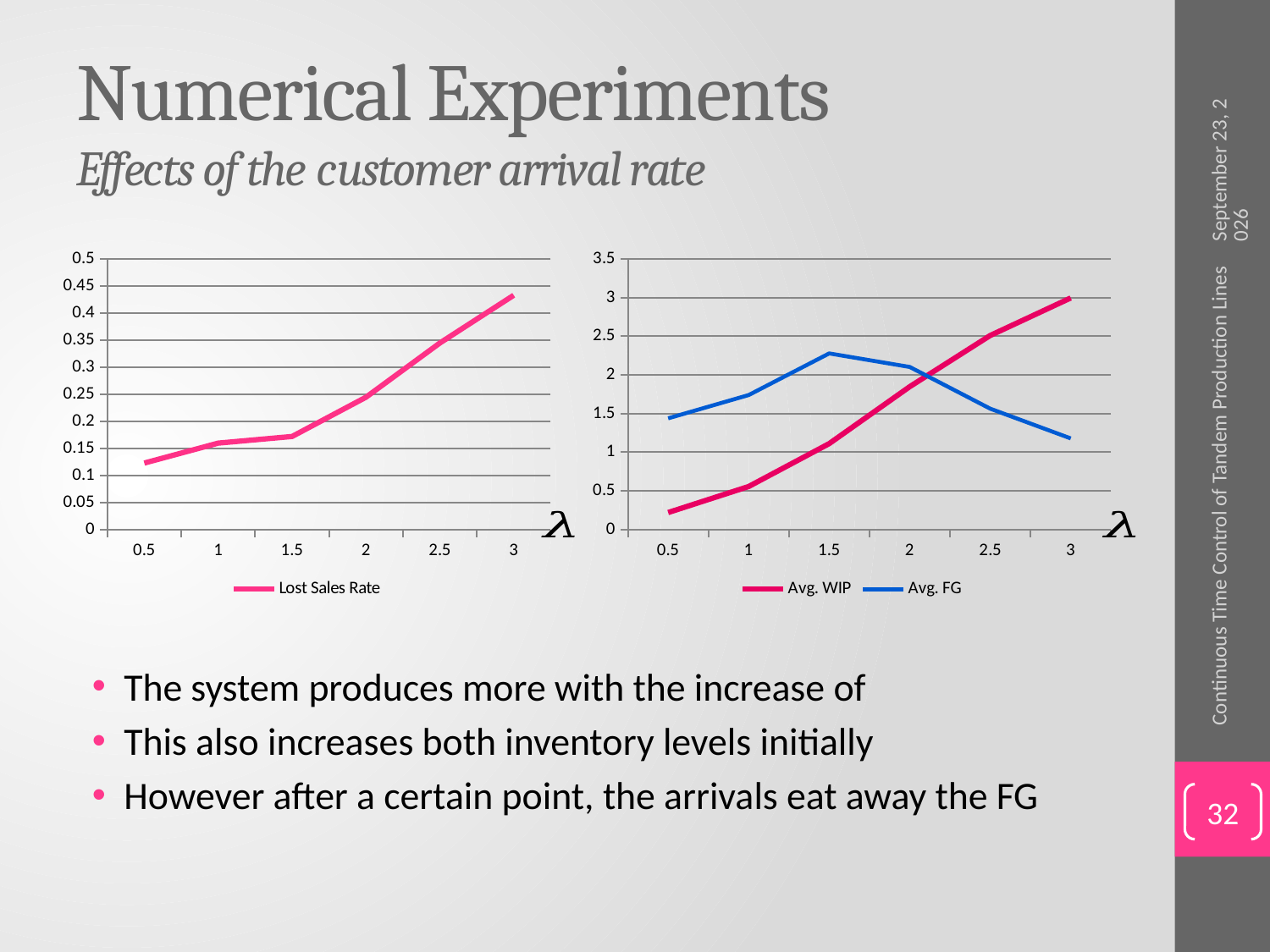
How many x-axis points are plotted in the left chart? 6 In the right chart, is Avg. WIP at λ = 2.5 greater or less than 2? greater In the left chart, is the Lost Sales Rate at λ = 0.5 greater or less than 0.15? less What series does the legend of the left chart list? Lost Sales Rate How many series does the legend of the right chart list? 2 What type of chart is the left chart on the slide? line chart In the right chart, at which value of λ is Avg. FG highest? 1.5 In the right chart, which is larger at λ = 3, Avg. WIP or Avg. FG? Avg. WIP In the right chart, at which value of λ is Avg. WIP lowest? 0.5 In the left chart, is the Lost Sales Rate at λ = 3 greater or less than 0.4? greater In the left chart, does the Lost Sales Rate rise or fall as λ increases from 0.5 to 3? rise In the right chart, which is larger at λ = 1, Avg. WIP or Avg. FG? Avg. FG